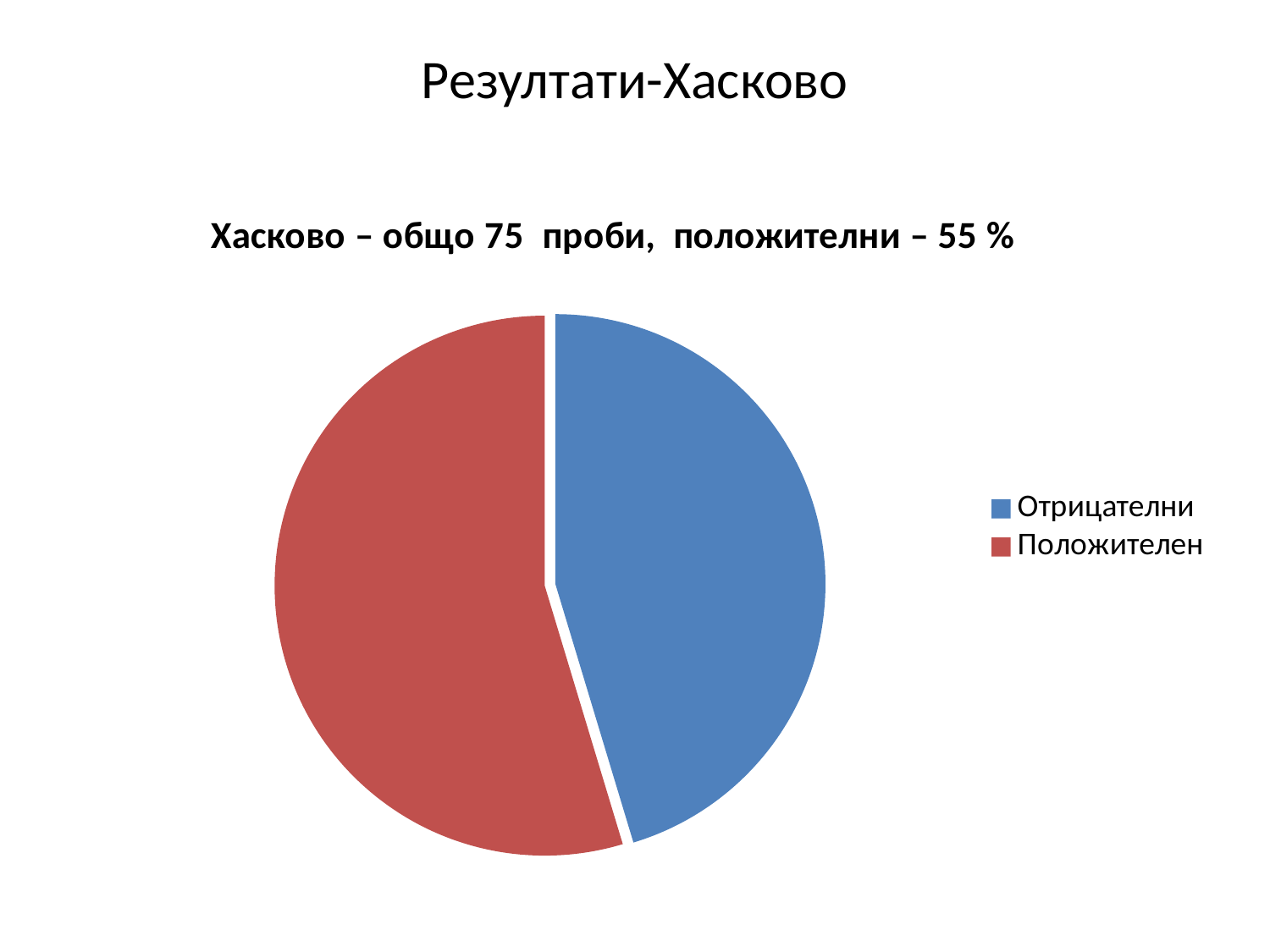
What share of the pie does the Положителен slice represent, according to the chart title? 55 % What kind of chart is shown on the slide? pie chart Which slice of the pie chart is the largest? Положителен Which slice is larger, Положителен or Отрицателни? Положителен What is the title of the pie chart? Хасково – общо 75 проби, положителни – 55 % How many slices does the pie chart have? 2 How many entries does the legend of the pie chart list? 2 What colour is the Отрицателни slice in the pie chart? blue Which slice of the pie chart is the smallest? Отрицателни